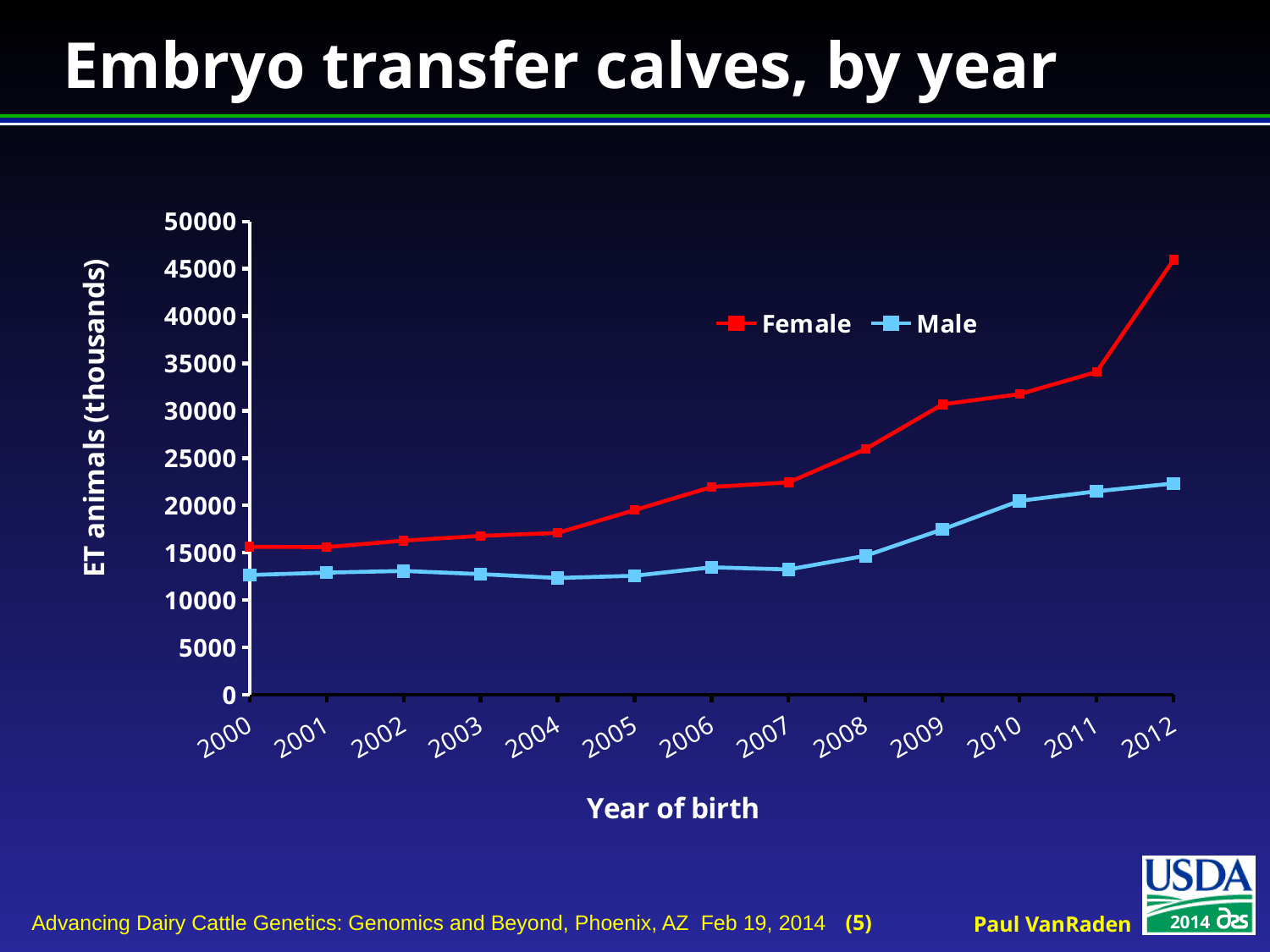
In which year is the Male series at its highest? 2012 Is the Male value for 2004 greater or less than 15000? less How many years are plotted along the x axis? 13 Is the Female value for 2012 greater or less than 40000? greater What kind of chart is shown on the slide? line chart Is the Male value for 2012 greater or less than 20000? greater In which year is the Female series at its highest? 2012 Which series has the larger value in 2012, Female or Male? Female How many series does the legend list? 2 Does the Female series generally rise or fall from 2000 to 2012? rise